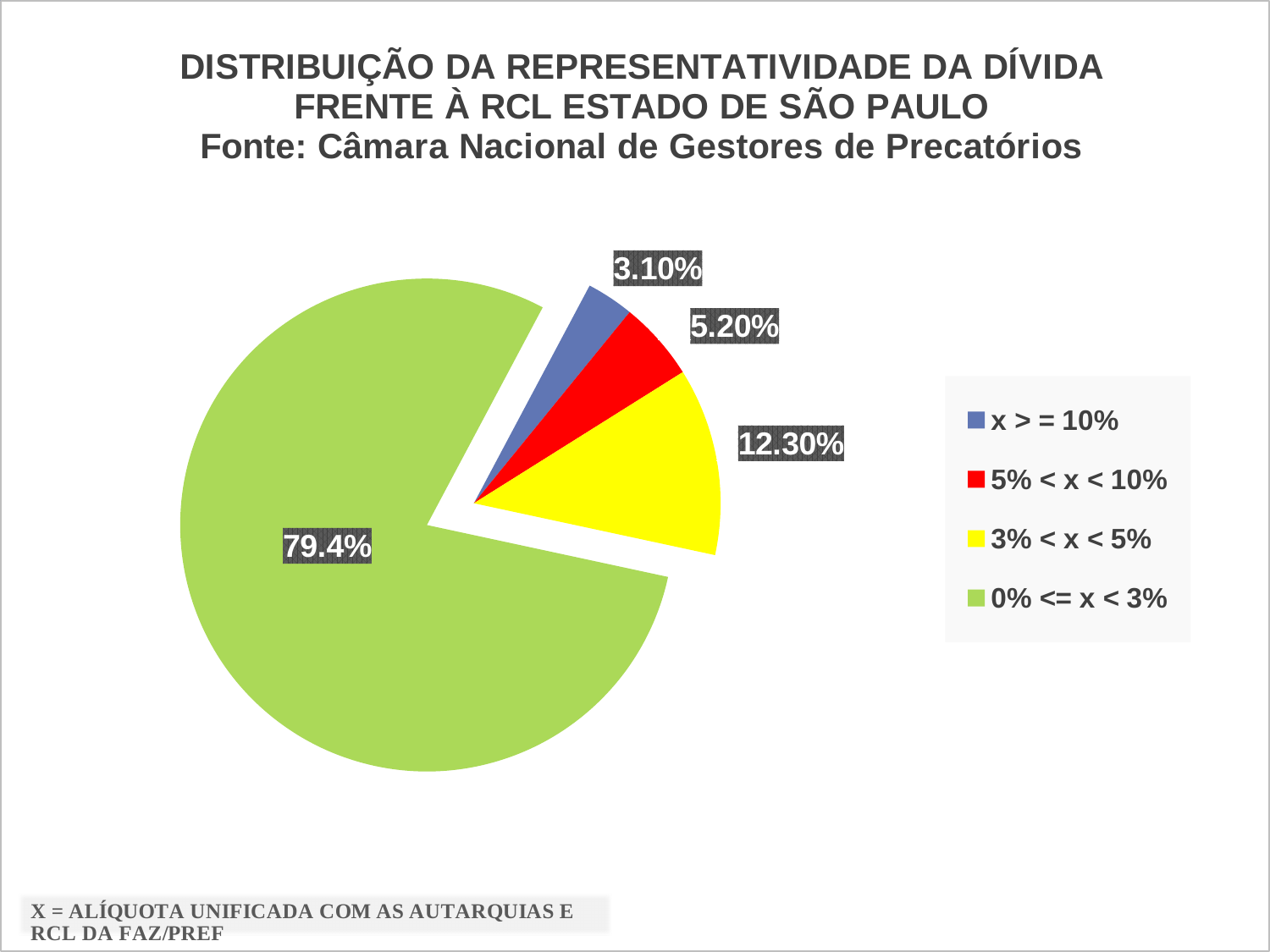
What colour is the "5% < x < 10%" slice? red What is the value for the "x > = 10%" slice? 3.10% Which category has the largest slice of the pie? 0% <= x < 3% What is the difference between the "3% < x < 5%" slice and the "5% < x < 10%" slice? 7.10% What is the value for the "0% <= x < 3%" slice? 79.4% How many entries does the legend list? 4 What kind of chart is shown on the slide? pie chart What is the value for the "3% < x < 5%" slice? 12.30% What is the value for the "5% < x < 10%" slice? 5.20% How many slices does the pie chart have? 4 Which category has the smallest slice of the pie? x > = 10% Which is larger, the "3% < x < 5%" slice or the "5% < x < 10%" slice? 3% < x < 5%